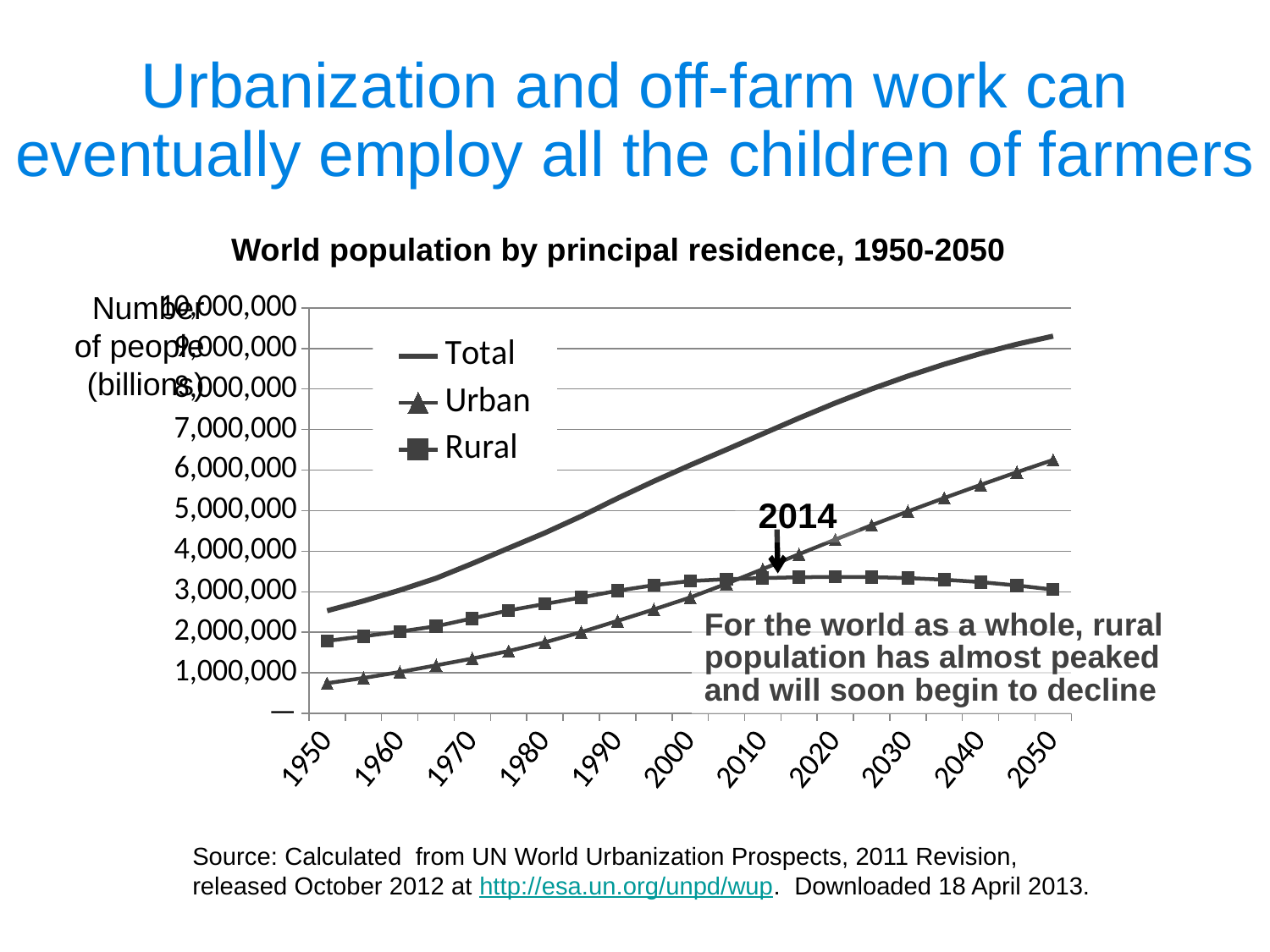
What kind of chart is shown on the slide? line chart Is the value for Urban in 2000 greater or less than 3,000,000? less In 2050, which is larger, the Urban population or the Rural population? Urban Is the value for Rural in 1950 greater or less than 2,000,000? less How many series does the chart's legend list? 3 Is the value for Urban in 1950 greater or less than 1,000,000? less Does the Total series rise or fall from 1950 to 2050? rise In 1950, which is larger, the Urban population or the Rural population? Rural How many year labels are shown along the x axis? 11 What are the three series named in the legend? Total, Urban, Rural What is the title of the chart? World population by principal residence, 1950-2050